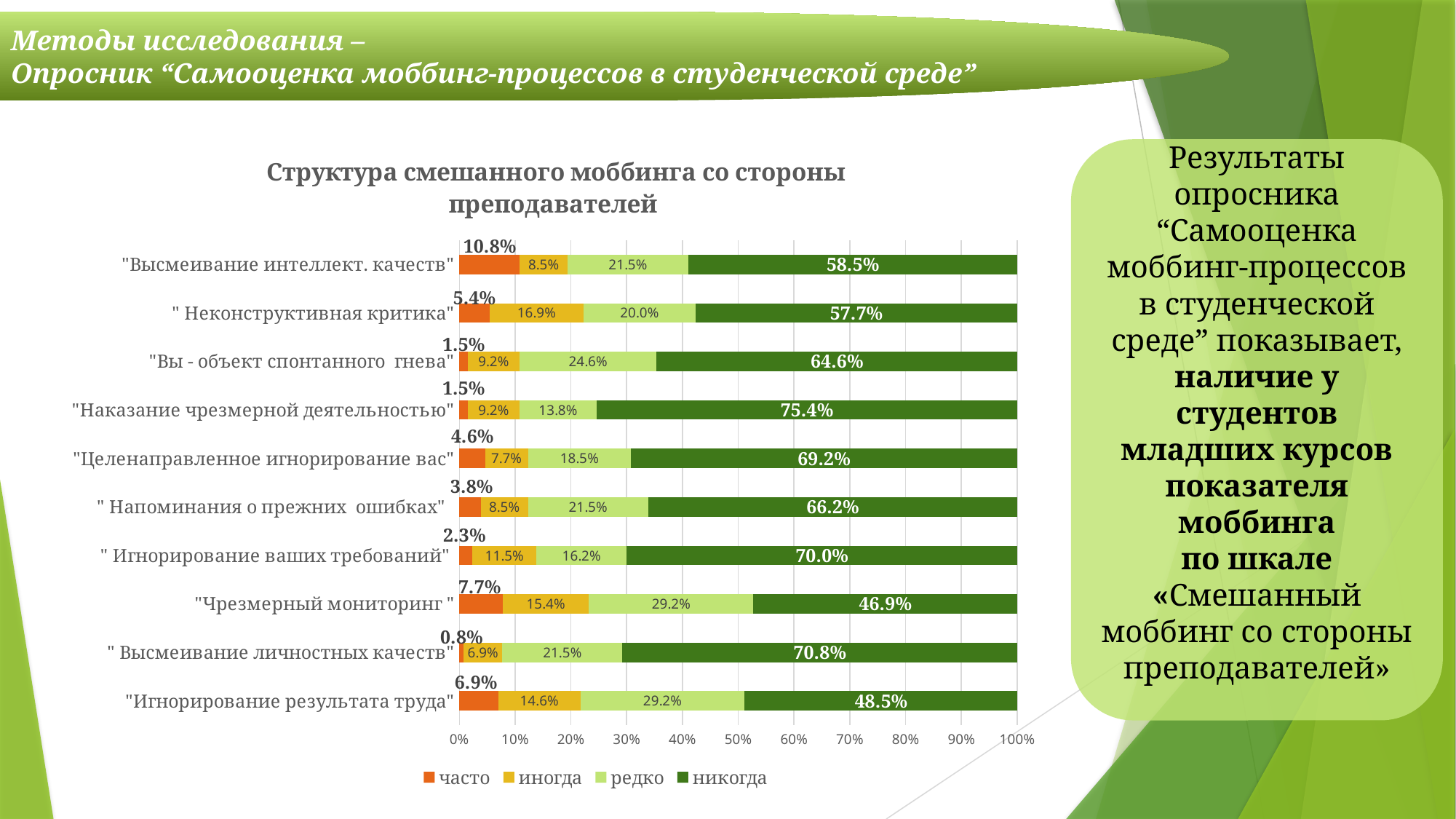
Which category has the highest "никогда" value? "Наказание чрезмерной деятельностью" What kind of chart is shown on the slide? Stacked bar chart Which category has the lowest "часто" value? "Высмеивание личностных качеств" What is the "иногда" value for "Неконструктивная критика"? 16.9% What is the "редко" value for "Чрезмерный мониторинг"? 29.2% How many series does the legend list? 4 What is the difference between the "никогда" values for "Наказание чрезмерной деятельностью" and "Чрезмерный мониторинг"? 28.5% Which category has the lowest "никогда" value? "Чрезмерный мониторинг" How many categories are plotted on the chart? 10 What is the "часто" value for "Высмеивание интеллект. качеств"? 10.8% Which is larger: the "никогда" value for "Игнорирование результата труда" or for "Высмеивание интеллект. качеств"? "Высмеивание интеллект. качеств" What is the "никогда" value for "Наказание чрезмерной деятельностью"? 75.4%